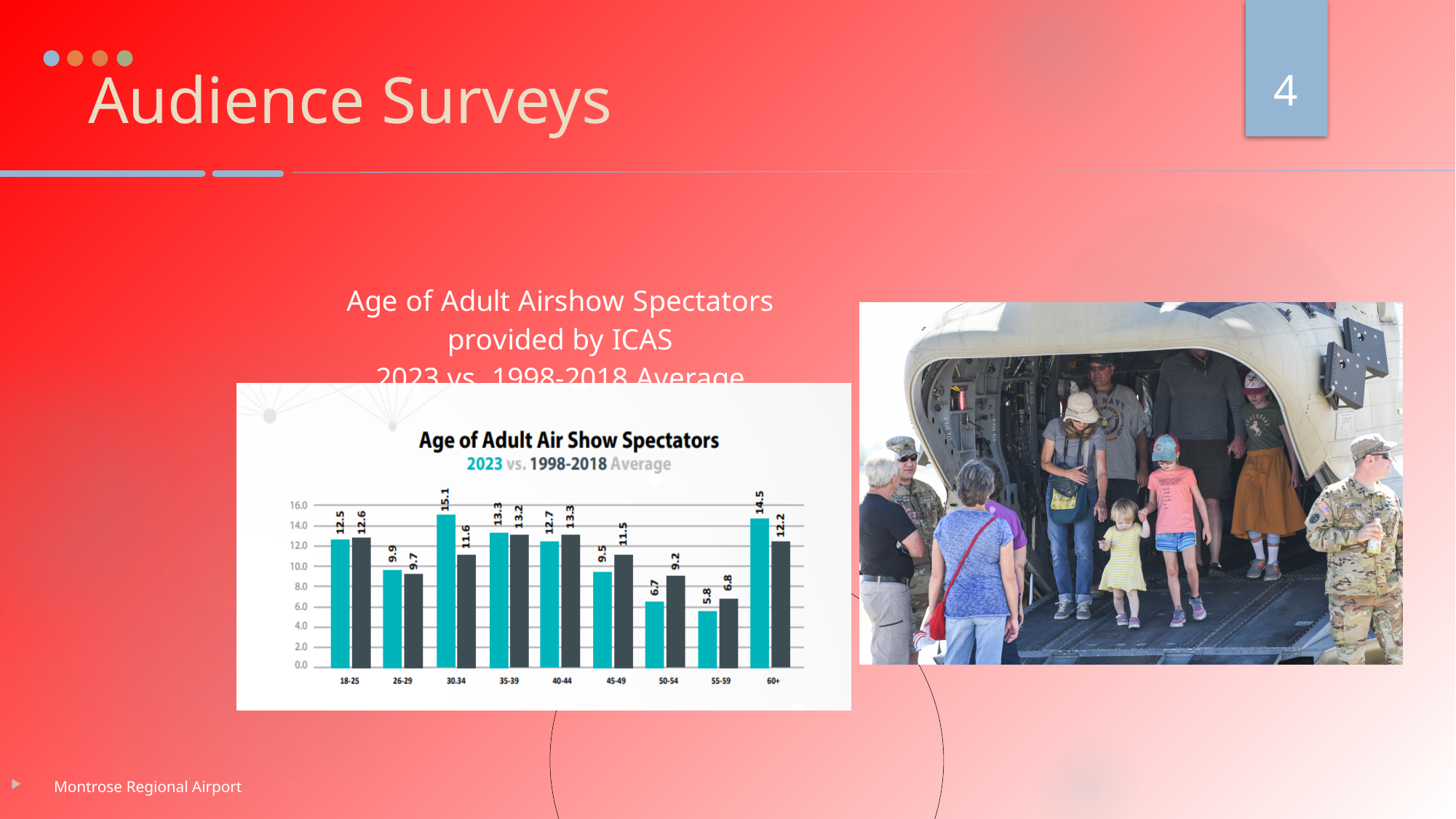
Which age group has the highest 2023 value? 30-34 What is the 2023 value for the 55-59 age group? 5.8 What kind of chart is shown on the slide? bar chart How many series does the chart compare? 2 What is the difference between the 2023 value and the 1998-2018 Average value for the 30-34 age group? 3.5 Which is larger for the 45-49 age group: the 2023 value or the 1998-2018 Average value? 1998-2018 Average What is the title of the chart? Age of Adult Air Show Spectators What is the 1998-2018 Average value for the 60+ age group? 12.2 Which age group has the lowest 1998-2018 Average value? 55-59 Is the 2023 value for the 60+ age group greater or less than 14.0? greater What is the 2023 value for the 30-34 age group? 15.1 How many age groups are shown on the x axis? 9